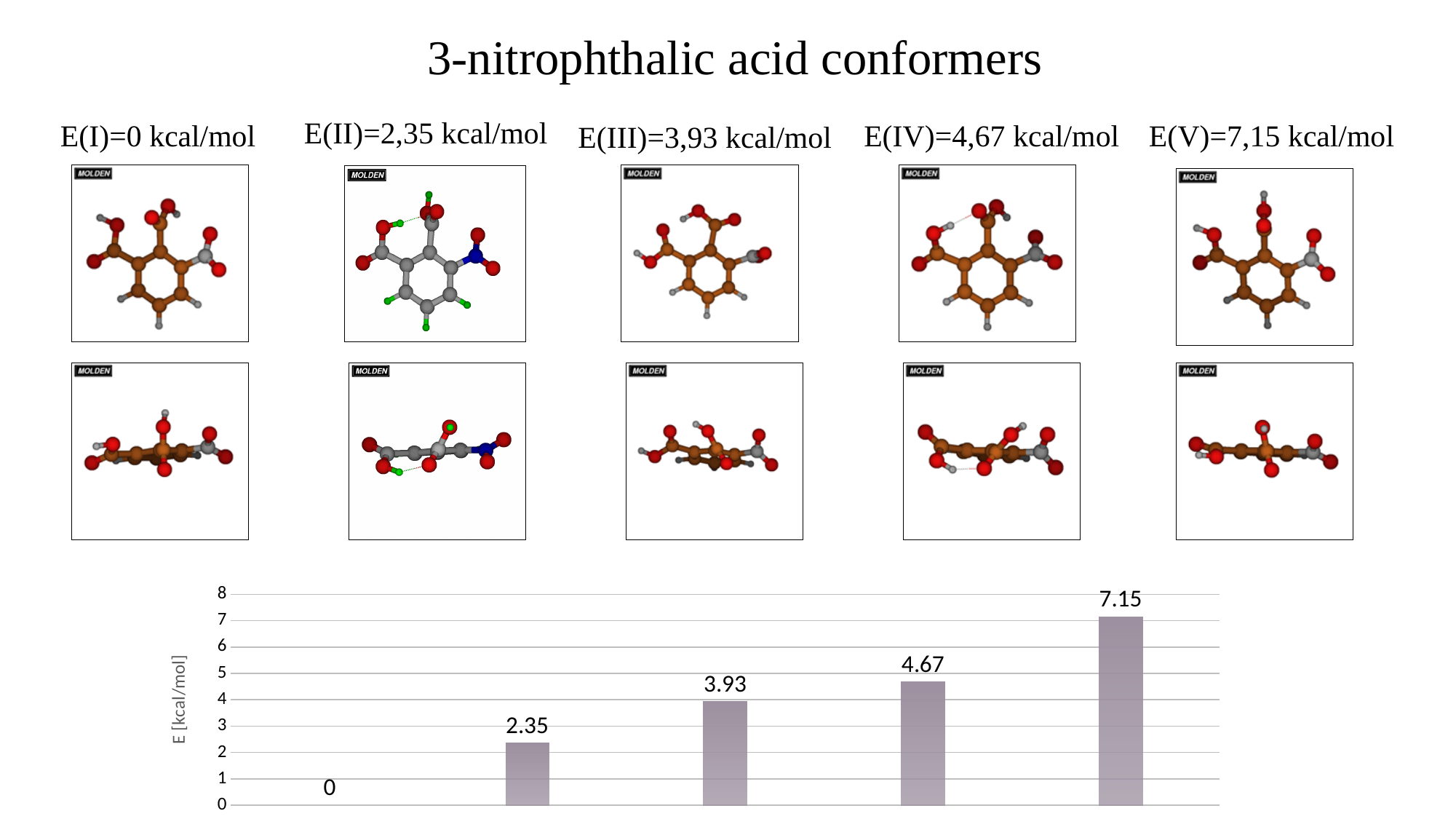
What is the value labelled on the rightmost bar in the chart? 7.15 What is the label on the vertical axis of the chart? E [kcal/mol] Which bar has the highest value in the chart? the rightmost bar (7.15) Which is larger in the chart: the third bar (3.93) or the second bar (2.35)? the third bar (3.93) What is the value labelled on the leftmost bar in the chart? 0 How many bars (data points) are plotted in the chart? 5 What is the value labelled on the second bar from the left in the chart? 2.35 What is the value labelled on the fourth bar from the left in the chart? 4.67 What is the value labelled on the third bar from the left in the chart? 3.93 Do the bar values rise or fall from left to right in the chart? rise What is the difference between the rightmost bar (7.15) and the fourth bar (4.67) in the chart? 2.48 What type of chart is shown at the bottom of the slide? bar chart